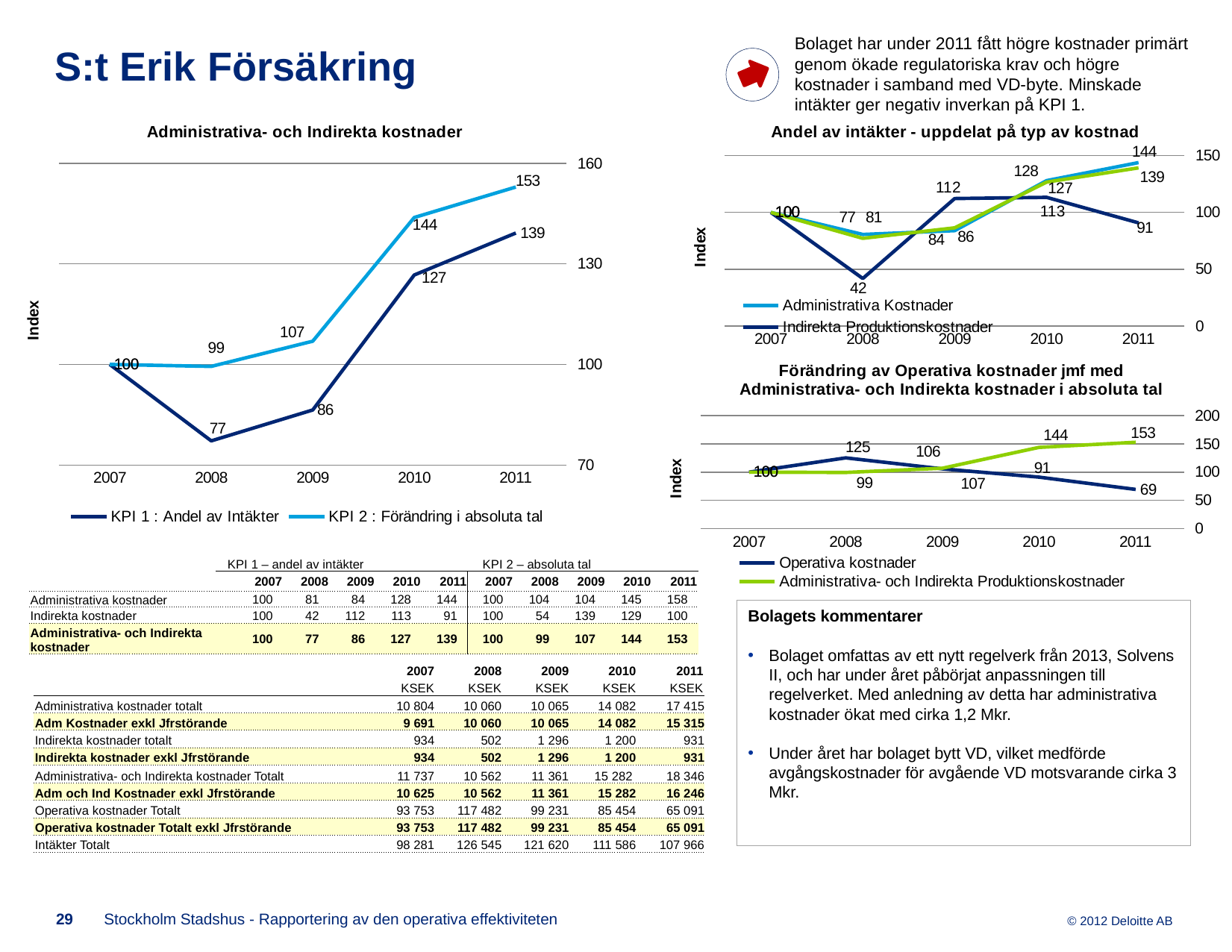
In the chart titled "Andel av intäkter - uppdelat på typ av kostnad", what is the value of Indirekta Produktionskostnader in 2008? 42 In the chart titled "Förändring av Operativa kostnader jmf med Administrativa- och Indirekta kostnader i absoluta tal", what is the value of Operativa kostnader in 2011? 69 In the chart titled "Administrativa- och Indirekta kostnader", what is the value of KPI 1 : Andel av Intäkter in 2010? 127 In the chart titled "Andel av intäkter - uppdelat på typ av kostnad", which series has the higher value in 2011? Administrativa Kostnader In the chart titled "Förändring av Operativa kostnader jmf med Administrativa- och Indirekta kostnader i absoluta tal", does Operativa kostnader rise or fall from 2008 to 2011? Fall In the chart titled "Andel av intäkter - uppdelat på typ av kostnad", in which year is Administrativa Kostnader highest? 2011 What type of chart is the chart titled "Administrativa- och Indirekta kostnader"? Line chart In the chart titled "Förändring av Operativa kostnader jmf med Administrativa- och Indirekta kostnader i absoluta tal", how many years are shown on the x axis? 5 In the chart titled "Administrativa- och Indirekta kostnader", in which year is KPI 1 : Andel av Intäkter lowest? 2008 In the chart titled "Administrativa- och Indirekta kostnader", how many series does the legend list? 2 In the chart titled "Administrativa- och Indirekta kostnader", what is the difference between KPI 2 and KPI 1 in 2011? 14 In the chart titled "Administrativa- och Indirekta kostnader", what is the value of KPI 2 : Förändring i absoluta tal in 2011? 153